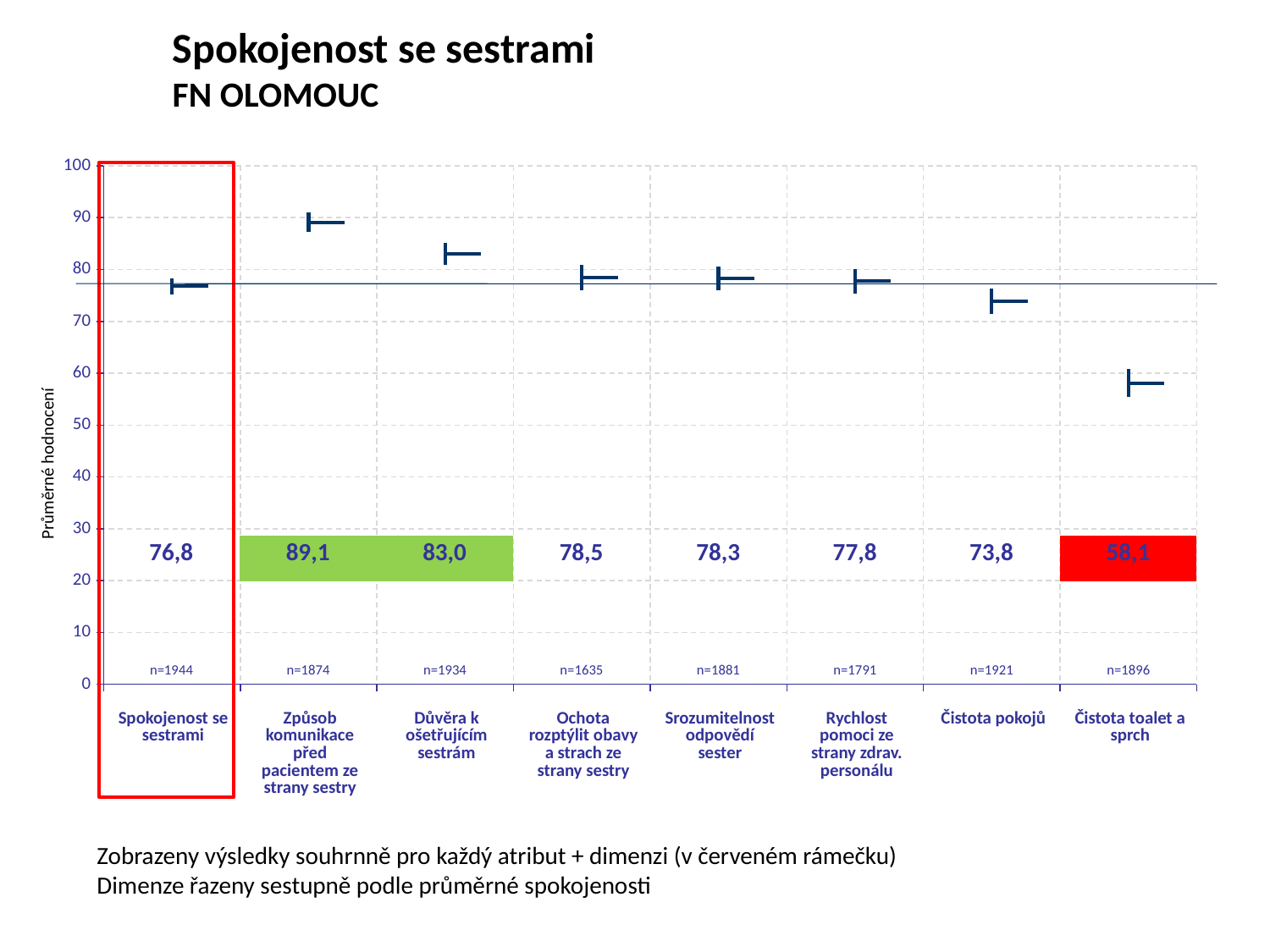
What is the difference between the values for Způsob komunikace před pacientem ze strany sestry and Čistota toalet a sprch? 31,0 Which category has the lowest value? Čistota toalet a sprch What is the sample size (n) shown for Ochota rozptýlit obavy a strach ze strany sestry? n=1635 How many categories are shown on the x axis? 8 Which category has the highest value? Způsob komunikace před pacientem ze strany sestry Which is larger, the value for Důvěra k ošetřujícím sestrám or the value for Čistota pokojů? Důvěra k ošetřujícím sestrám What is the label of the vertical axis? Průměrné hodnocení Is the value for Čistota toalet a sprch greater or less than 60? less What is the value for Čistota toalet a sprch? 58,1 What is the value for Způsob komunikace před pacientem ze strany sestry? 89,1 What is the value for Rychlost pomoci ze strany zdrav. personálu? 77,8 What is the value for Spokojenost se sestrami? 76,8